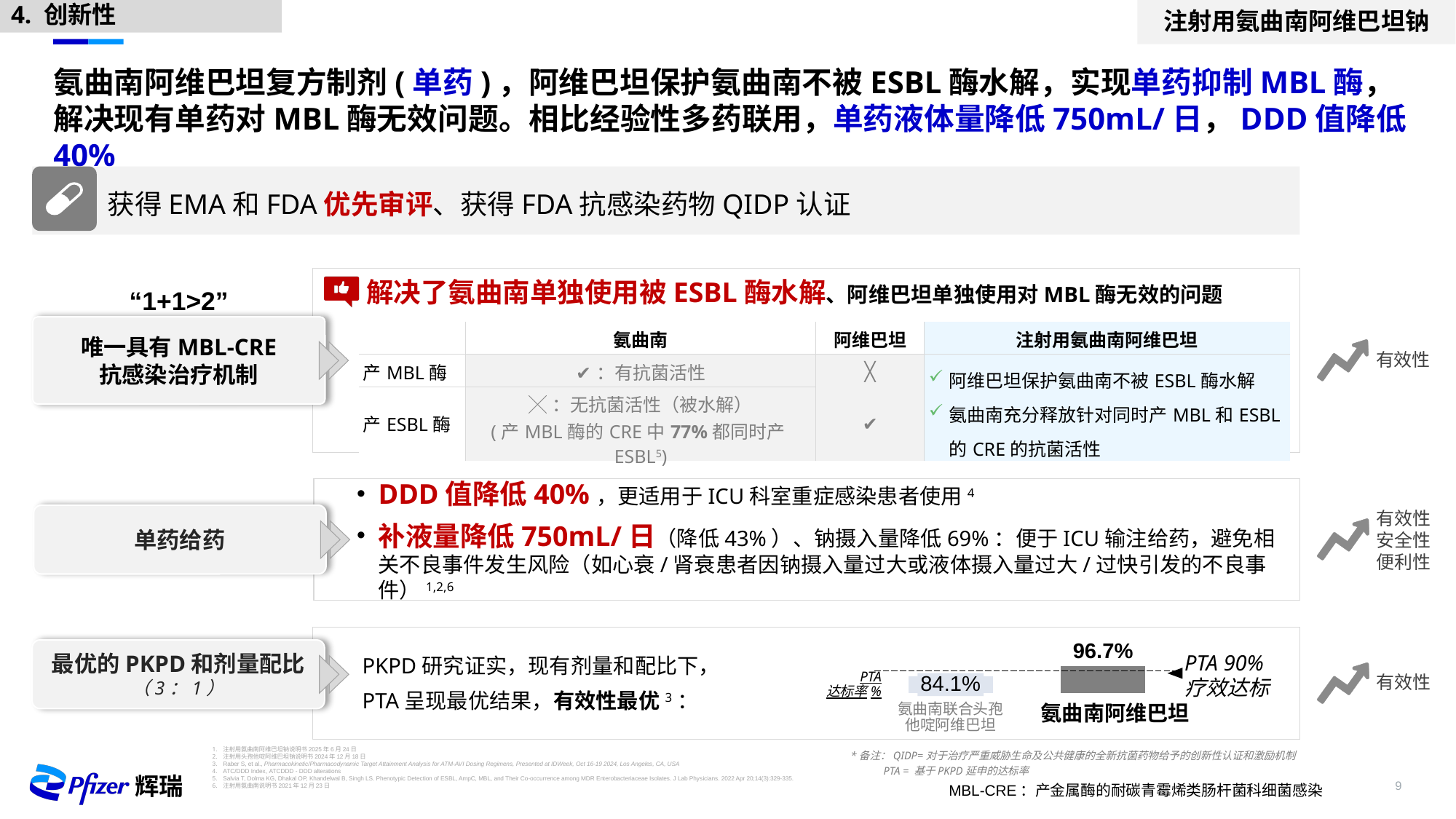
How many categories are shown in the PTA 达标率 chart? 2 In the PTA 达标率 chart, which category has the highest value? 氨曲南阿维巴坦 What kind of chart is the PTA 达标率 chart? bar chart In the PTA 达标率 chart, what is the difference between the values for 氨曲南阿维巴坦 and 氨曲南联合头孢他啶阿维巴坦? 12.6% In the PTA 达标率 chart, what is the label of the y axis? PTA 达标率 % In the PTA 达标率 chart, is the value for 氨曲南阿维巴坦 greater or less than the 90% PTA line? greater In the PTA 达标率 chart, is the value for 氨曲南联合头孢他啶阿维巴坦 greater or less than the 90% PTA line? less In the PTA 达标率 chart, what is the value for 氨曲南联合头孢他啶阿维巴坦? 84.1% In the PTA 达标率 chart, which category has the lowest value? 氨曲南联合头孢他啶阿维巴坦 In the PTA 达标率 chart, what threshold does the dashed line represent? PTA 90% 疗效达标 In the PTA 达标率 chart, what is the value for 氨曲南阿维巴坦? 96.7% In the PTA 达标率 chart, which is larger: the value for 氨曲南阿维巴坦 or for 氨曲南联合头孢他啶阿维巴坦? 氨曲南阿维巴坦